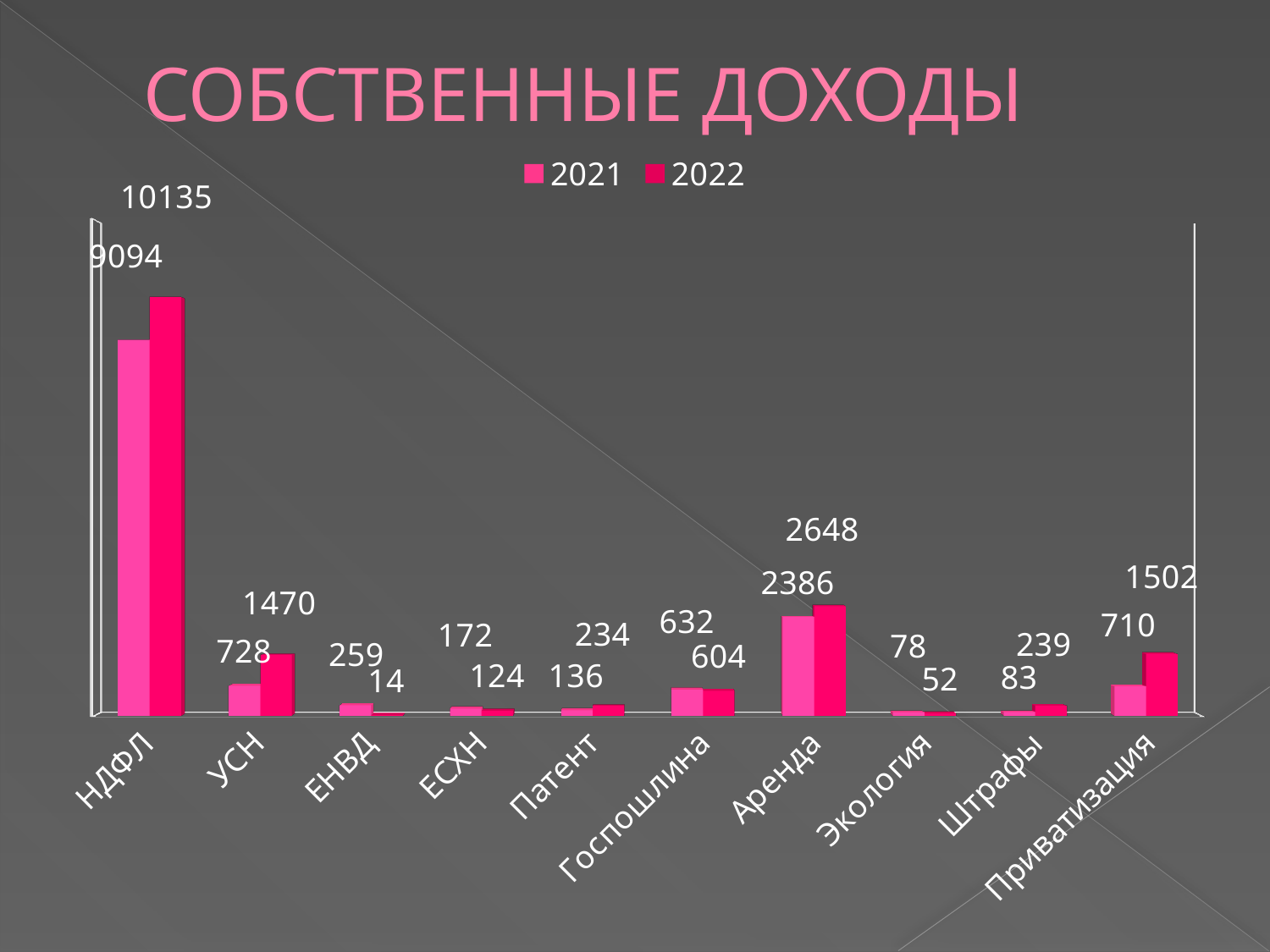
What is the value for НДФЛ in 2022? 10135 What is the value for Приватизация in 2022? 1502 How many categories are shown on the x axis? 10 How many series does the legend list? 2 Which category has the lowest value in 2022? ЕНВД What is the value for ЕНВД in 2022? 14 What is the title of the chart? СОБСТВЕННЫЕ ДОХОДЫ What kind of chart is shown on the slide? Bar chart Which category has the highest value in 2021? НДФЛ What is the difference between the 2022 and 2021 values for УСН? 742 What is the value for Аренда in 2021? 2386 Which is larger for Госпошлина: the 2021 value or the 2022 value? 2021